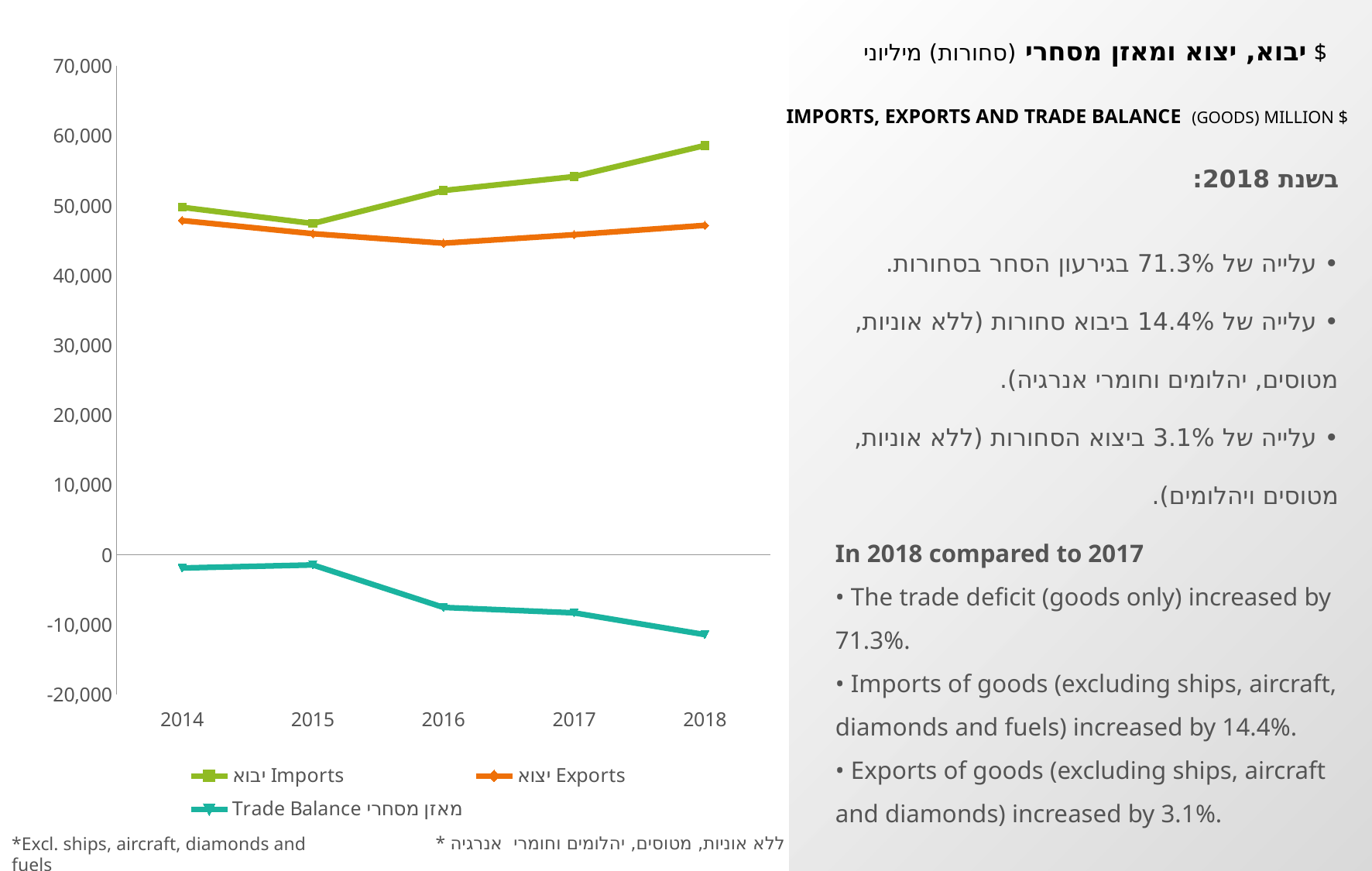
In which year is the Exports value lowest? 2016 In which year is the Imports value lowest? 2015 Does the Trade Balance line rise or fall from 2015 to 2018? fall Is the Trade Balance value for 2018 greater or less than -10,000? less Is the Exports value for 2016 greater or less than 50,000? less In which year is the Imports value highest? 2018 How many series does the chart legend list? 3 Is the Imports value for 2018 greater or less than 50,000? greater In which year is the Trade Balance value lowest? 2018 What kind of chart is shown on the slide? line chart In 2018, which is larger, Imports or Exports? Imports How many years are plotted along the x axis? 5